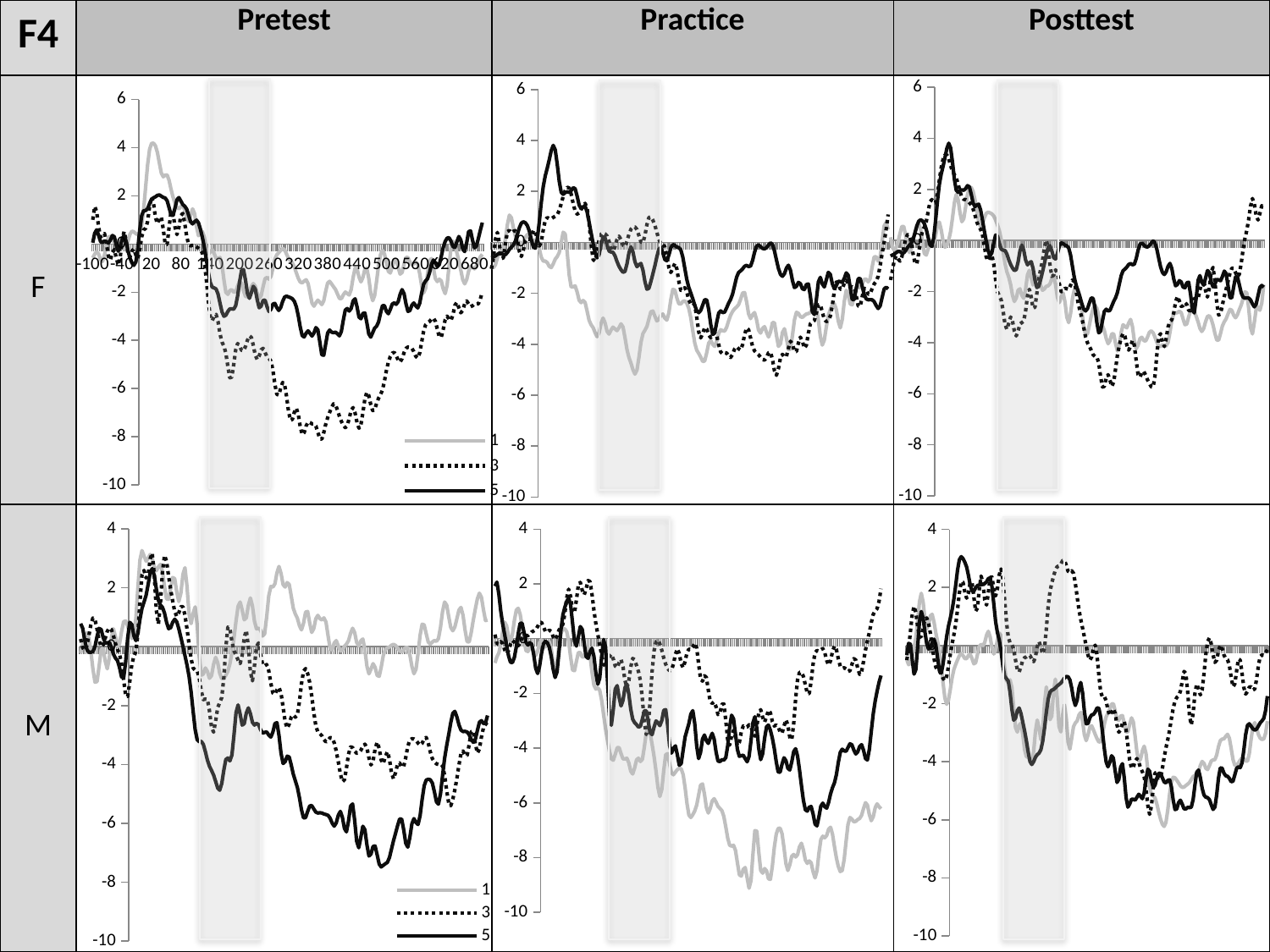
In the M Practice chart, is the lowest value of series 1 greater or less than -8? less In the F Pretest chart, is the lowest value of series 3 greater or less than -6? less In the F Pretest chart, which series reaches the highest peak? 1 How many charts are shown on the slide? 6 How many series does the legend in the F Pretest chart list? 3 In the M Pretest chart, which series reaches the lowest value? 5 In the M Practice chart, which series reaches the lowest value? 1 In the F Practice chart, is the highest peak of series 5 greater or less than 2? greater What are the legend entries shown in the M Pretest chart? 1, 3, 5 What are the three column headings above the charts? Pretest, Practice, Posttest What kind of chart is shown in the F Pretest panel? line chart In the F Pretest chart, which series reaches the lowest value? 3